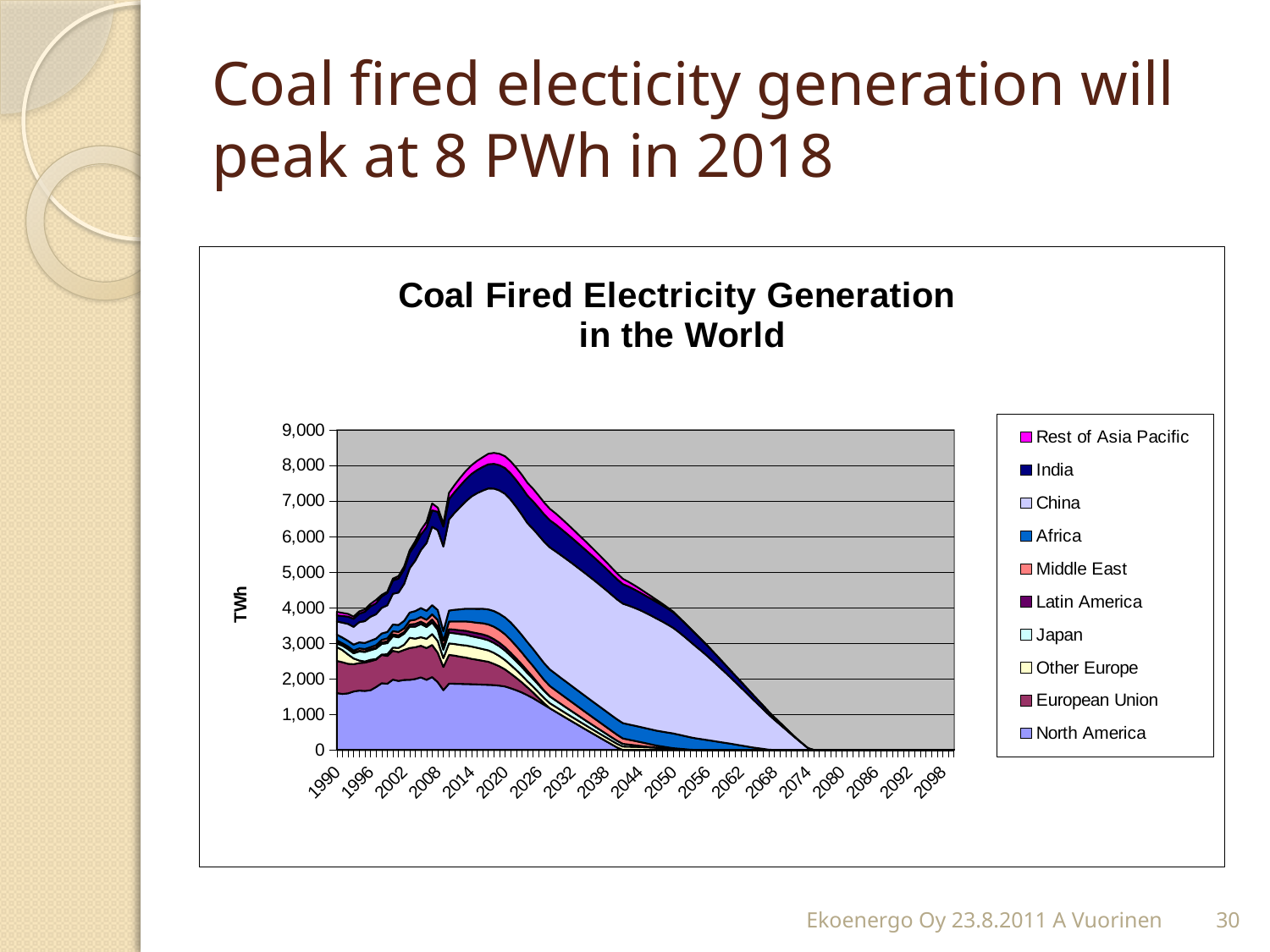
Is the total coal fired electricity generation in 2080 greater or less than 1,000 TWh? less What is the title of the chart? Coal Fired Electricity Generation in the World What kind of chart is shown on the slide? Stacked area chart What unit is shown on the vertical axis of the chart? TWh Is the total coal fired electricity generation in 2008 greater or less than 5,000 TWh? greater How many series does the legend of the chart list? 10 Is the total coal fired electricity generation in 2050 greater or less than 5,000 TWh? less Which series is plotted at the bottom of the stack in the chart? North America Which region contributes the largest share of coal fired electricity generation around 2040? China Does the total coal fired electricity generation rise or fall between 2026 and 2068? fall Does the total coal fired electricity generation rise or fall between 1990 and 2014? rise